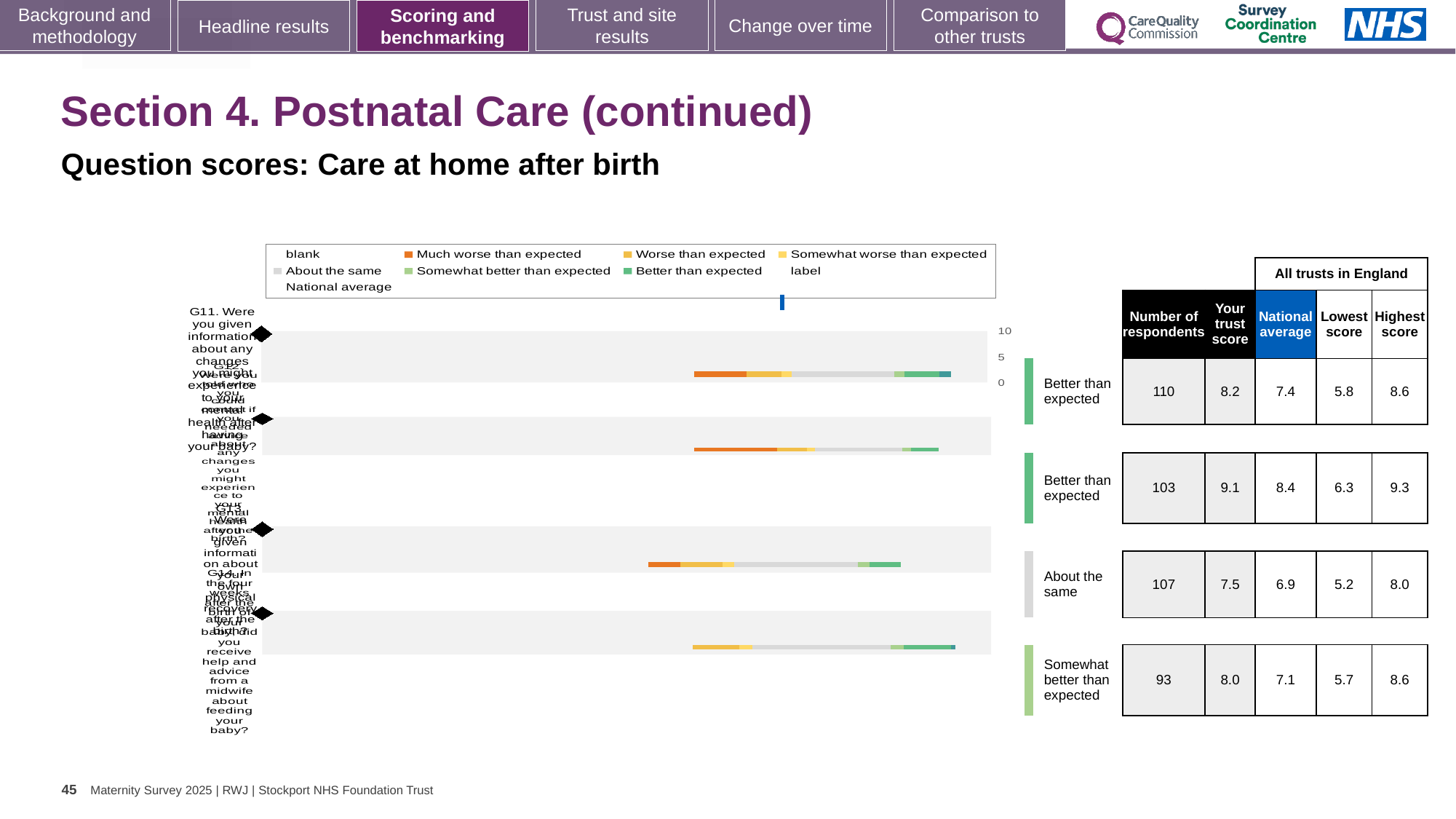
In the table to the right of the chart, for the third row, which is larger: the trust score or the national average? the trust score (7.5) In the table to the right of the chart, what is the highest score for the fourth row? 8.6 In the table to the right of the chart, what is the trust score for the second row? 9.1 In the table to the right of the chart, which row has the highest trust score? the second row (9.1) How many of the four rows are rated 'Better than expected' in the benchmark labels beside the chart? 2 What kind of chart is shown on the slide? bar chart In the table to the right of the chart, what is the difference between the trust score and the national average for the first row? 0.8 In the table to the right of the chart, which row has the smallest 'Lowest score' value? the third row (5.2) In the table to the right of the chart, what is the number of respondents for the first row (top bar)? 110 How many horizontal bars (question rows) are plotted in the chart? 4 In the chart legend, which category is shown with the orange marker? Much worse than expected